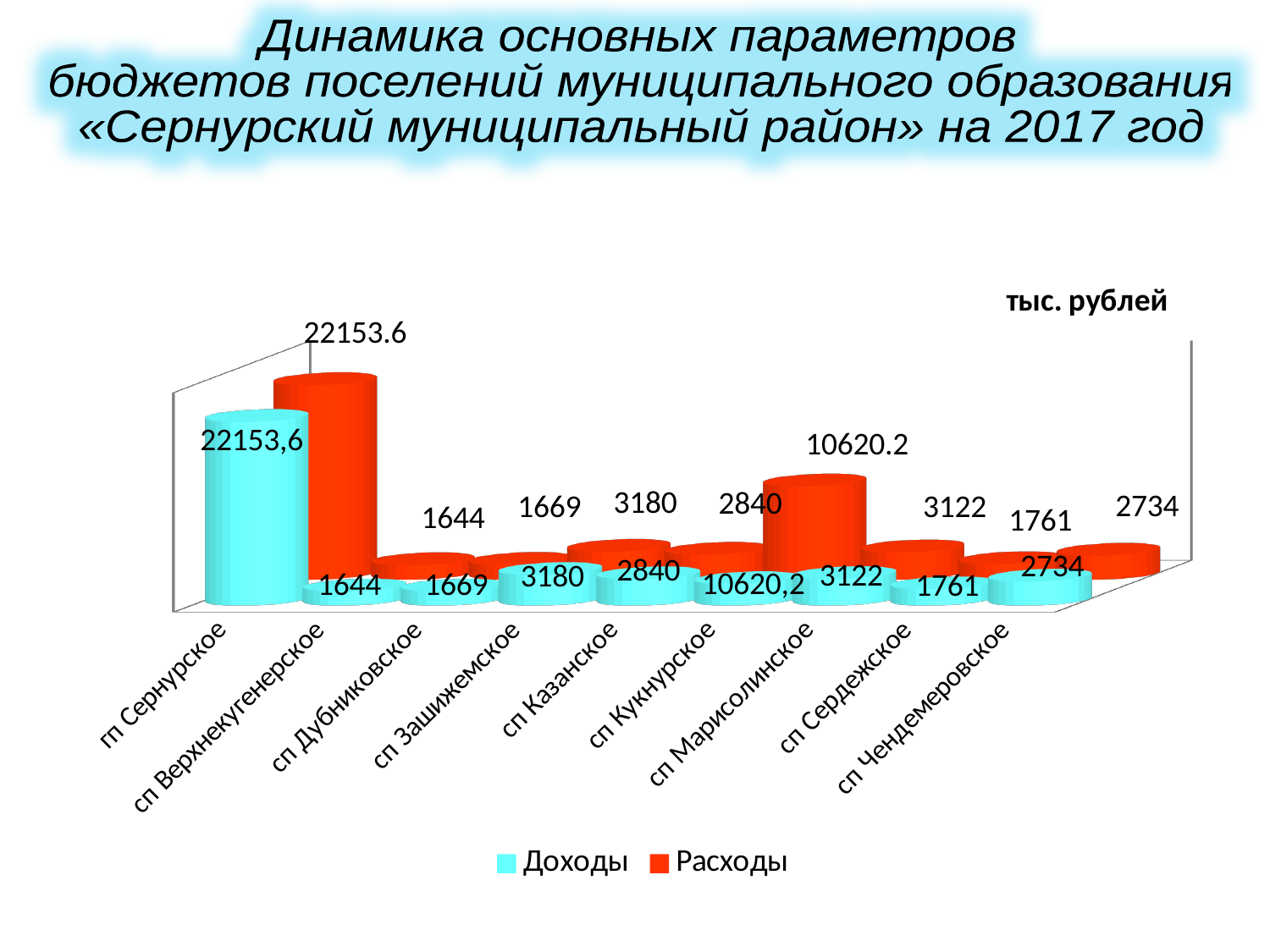
What is the difference between the Расходы values for сп Сердежское and сп Дубниковское? 92 What is the Расходы value for сп Марисолинское? 3122 What is the Расходы value for сп Чендемеровское? 2734 What kind of chart is shown on the slide? bar chart How many settlements (categories) are shown on the x axis? 9 Which settlement has the highest Расходы value? гп Сернурское How many series does the legend list? 2 What unit is indicated in the top right corner of the chart? тыс. рублей